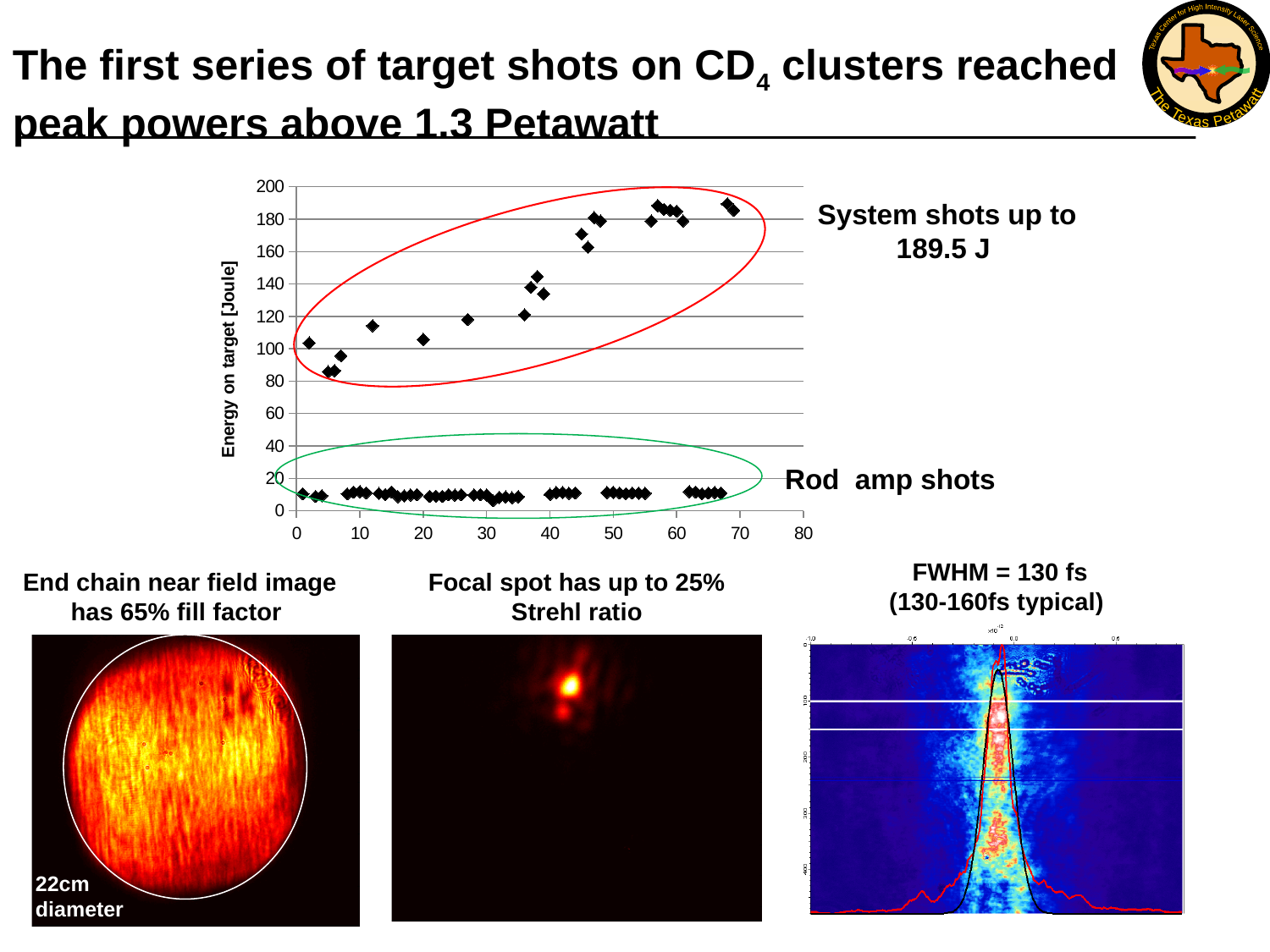
Are the system shots plotted between shot 55 and shot 70 greater or less than 160 Joule? greater Is the system shot plotted at about shot number 12 greater or less than 100 Joule? greater Do the system shot energies rise or fall as the shot number increases along the x axis? rise According to the annotation next to the chart, what is the maximum energy reached by the system shots? 189.5 J Which group of shots has higher energy on target, the system shots or the rod amp shots? system shots What is the label of the vertical axis of the chart? Energy on target [Joule] What is the highest value shown on the vertical axis of the chart? 200 Are the rod amp shots in the chart greater or less than 20 Joule? less What kind of chart is shown on the slide? scatter chart